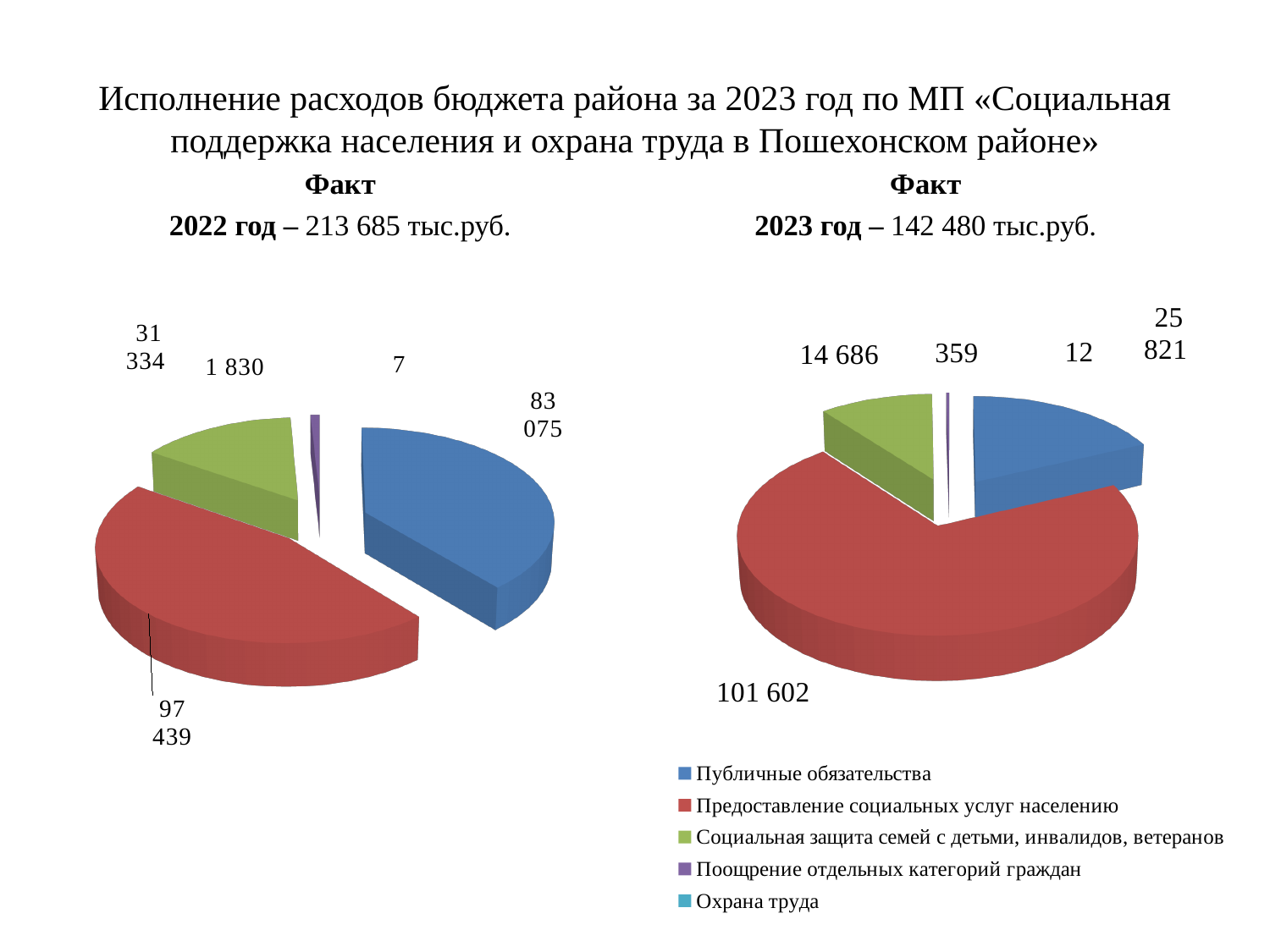
How many categories does the legend list? 5 In the 2023 pie chart, what is the difference between Предоставление социальных услуг населению and Публичные обязательства? 75 781 In the 2023 pie chart, what is the value for Публичные обязательства? 25 821 In the 2022 pie chart, what is the value for Поощрение отдельных категорий граждан? 1 830 What kind of chart is used for the 2023 data? Pie chart Which is larger in the 2022 pie chart: Публичные обязательства or Социальная защита семей с детьми, инвалидов, ветеранов? Публичные обязательства In the 2023 pie chart, which category has the largest value? Предоставление социальных услуг населению In the 2022 pie chart, which category has the smallest value? Охрана труда In the 2022 pie chart, what is the value for Предоставление социальных услуг населению? 97 439 What is the total for the 2023 pie chart as stated on the slide? 142 480 тыс.руб. Which colour represents Охрана труда in the legend? Teal In the 2023 pie chart, what is the value for Социальная защита семей с детьми, инвалидов, ветеранов? 14 686